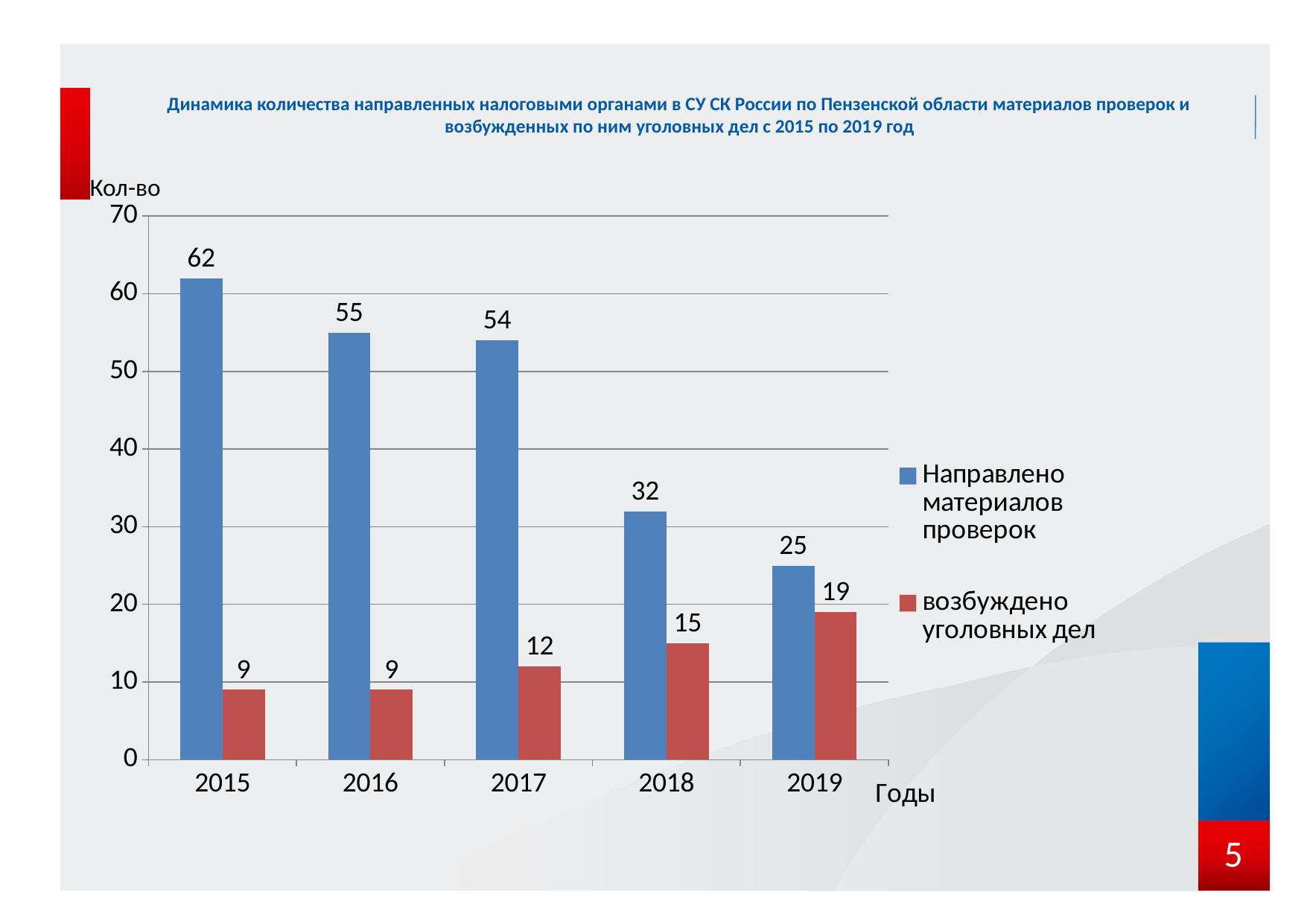
What is the value of "Направлено материалов проверок" for 2015? 62 Which year has the highest value for "Направлено материалов проверок"? 2015 How many years are shown on the x axis? 5 Which is larger: "Направлено материалов проверок" in 2016 or in 2017? 2016 Which year has the highest value for "возбуждено уголовных дел"? 2019 How many series does the legend list? 2 Which year has the lowest value for "Направлено материалов проверок"? 2019 Does the value of "Направлено материалов проверок" rise or fall from 2015 to 2019? fall What is the difference between "Направлено материалов проверок" and "возбуждено уголовных дел" in 2018? 17 What is the value of "возбуждено уголовных дел" for 2019? 19 What is the value of "возбуждено уголовных дел" for 2017? 12 What kind of chart is shown on the slide? bar chart